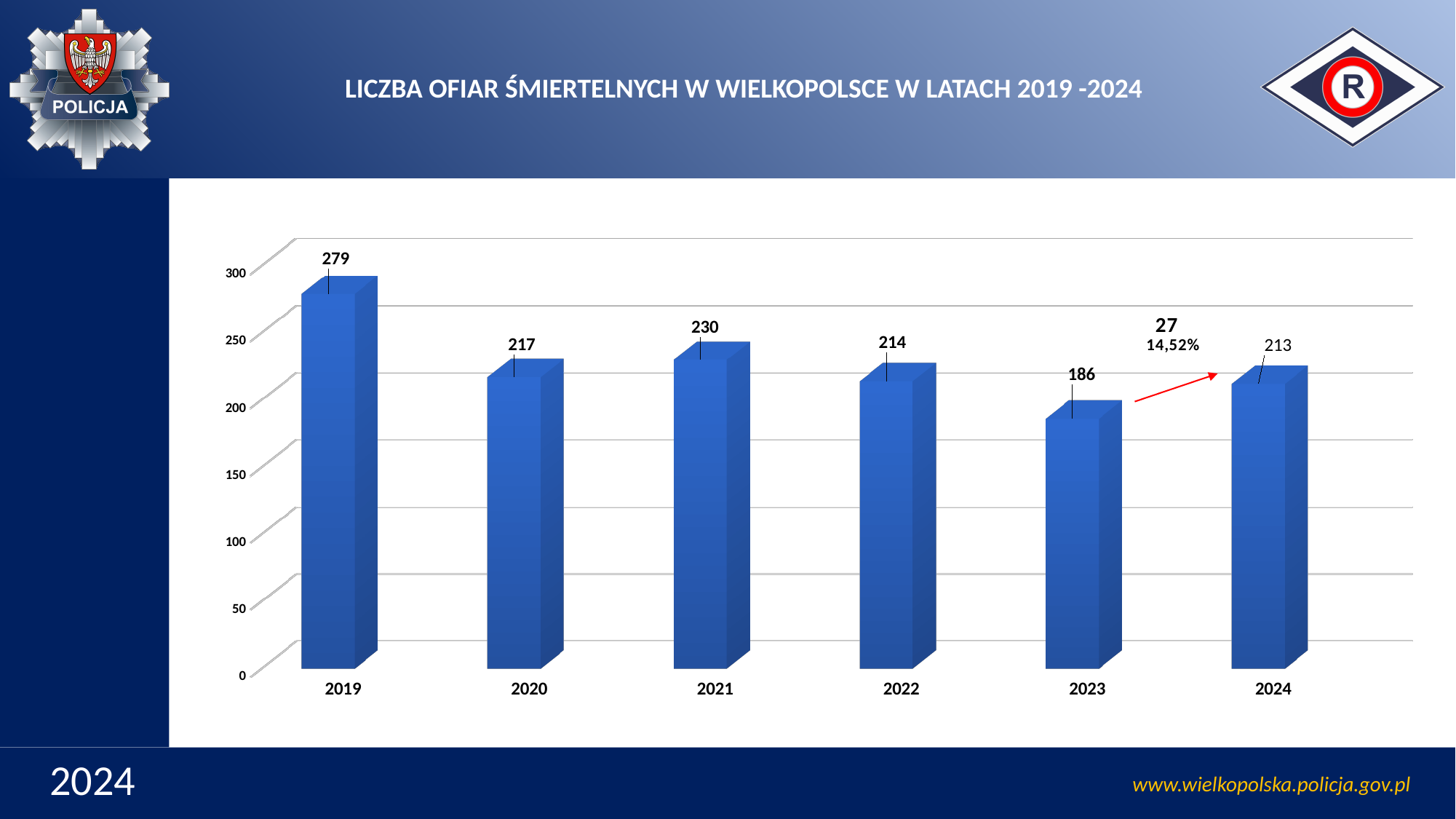
How many years are shown on the x axis? 6 What percentage change is annotated between 2023 and 2024? 14,52% Which year has the highest value? 2019 What is the title of the chart? LICZBA OFIAR ŚMIERTELNYCH W WIELKOPOLSCE W LATACH 2019 -2024 What kind of chart is shown on the slide? bar chart Which is larger, the value for 2021 or the value for 2022? 2021 What is the difference between the values for 2024 and 2023? 27 What is the difference between the values for 2019 and 2020? 62 What is the value for 2024? 213 What is the value for 2019? 279 What is the value for 2023? 186 Which year has the lowest value? 2023